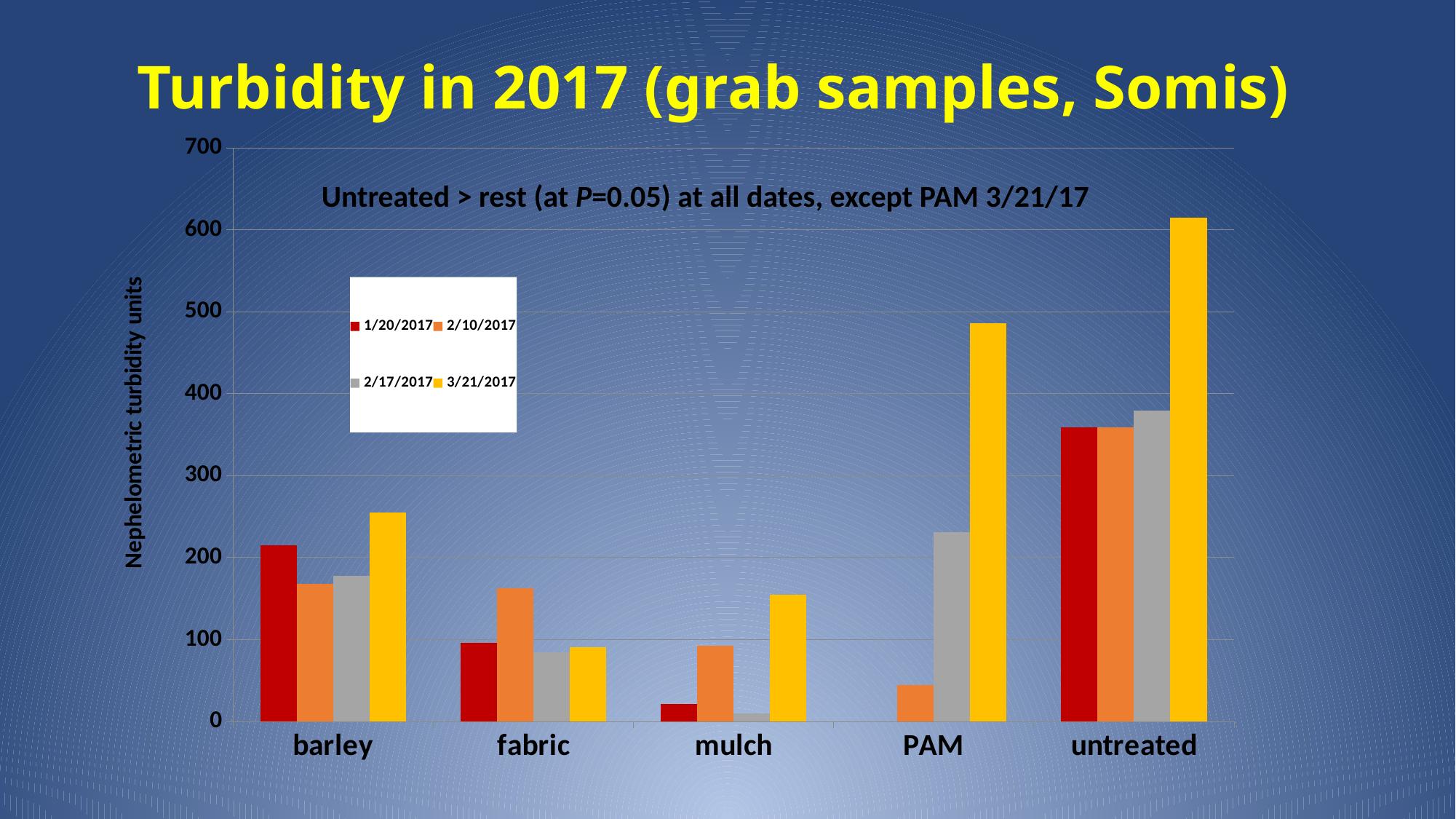
Is the value for PAM on 3/21/2017 greater or less than 500? less Which category has the lowest value for 3/21/2017? fabric Is the value for PAM on 2/17/2017 greater or less than 200? greater Which is larger for 1/20/2017: barley or fabric? barley Which category has the highest value for 3/21/2017? untreated Is the value for untreated on 3/21/2017 greater or less than 600? greater For mulch, which date has the larger value: 2/10/2017 or 3/21/2017? 3/21/2017 What is the label on the y axis? Nephelometric turbidity units How many series does the legend list? 4 What kind of chart is shown on the slide? bar chart How many treatment categories are shown on the x axis? 5